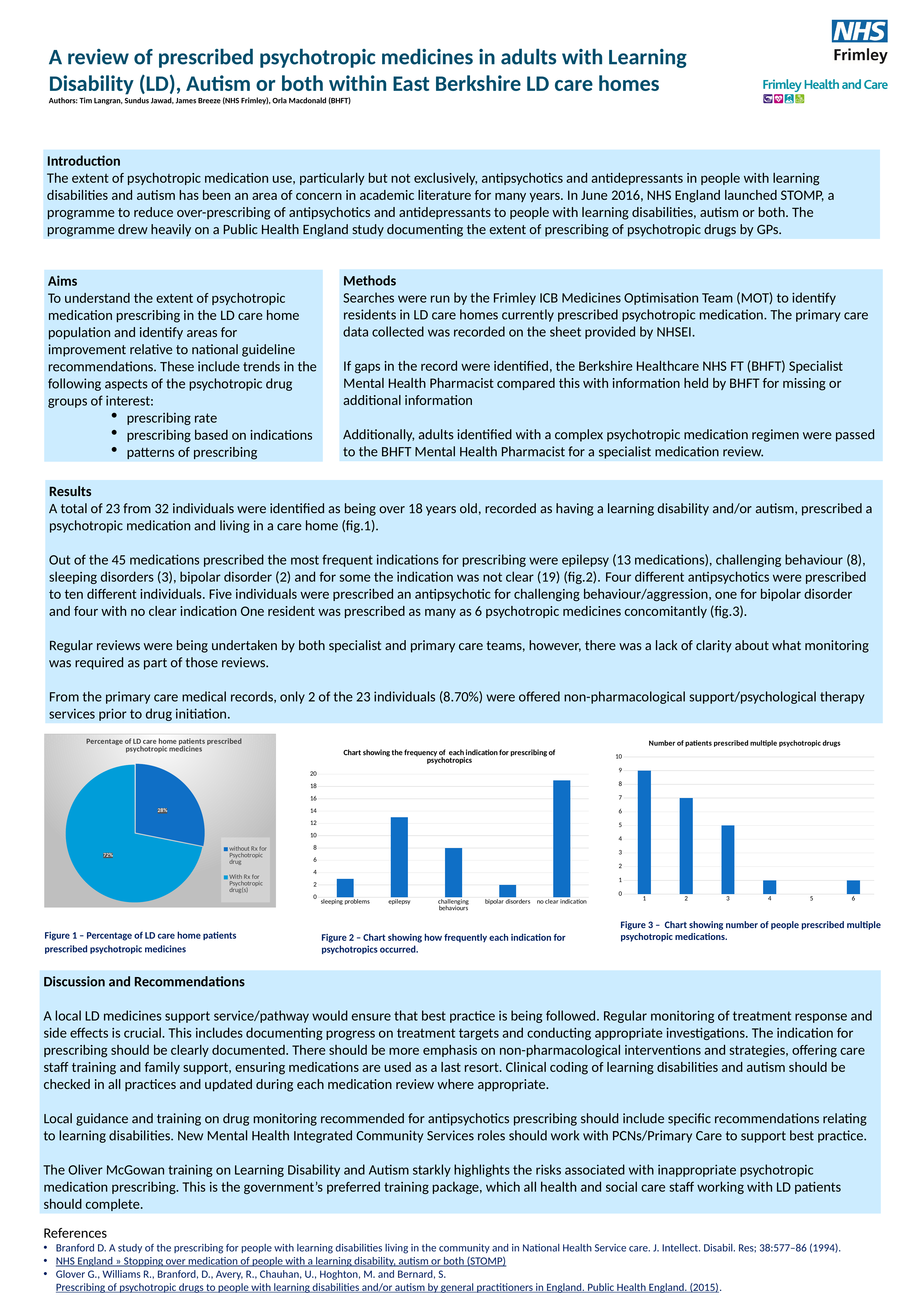
In Figure 3, the chart of number of patients prescribed multiple psychotropic drugs, how many patients were prescribed 1 drug? 9 In Figure 2, the chart showing the frequency of each indication, which indication has the lowest bar? bipolar disorders What type of chart is Figure 3, the chart of number of patients prescribed multiple psychotropic drugs? bar chart In Figure 1, the pie chart of LD care home patients prescribed psychotropic medicines, what percentage is shown for the 'With Rx for Psychotropic drug(s)' slice? 72% In Figure 1, the pie chart, what percentage of patients are 'without Rx for Psychotropic drug'? 28% In Figure 2, the chart showing the frequency of each indication, is the value for epilepsy greater or less than 10? greater In Figure 2, the chart showing the frequency of each indication for prescribing of psychotropics, which indication has the highest bar? no clear indication In Figure 2, the chart showing the frequency of each indication, what is the value for challenging behaviours? 8 In Figure 3, the chart of number of patients prescribed multiple psychotropic drugs, what is the difference between the number of patients on 2 drugs and the number on 3 drugs? 2 In Figure 2, the chart showing the frequency of each indication, how many indication categories are shown on the x axis? 5 In Figure 3, the chart of number of patients prescribed multiple psychotropic drugs, which category has the highest bar? 1 In Figure 1, how many slices does the pie chart have? 2